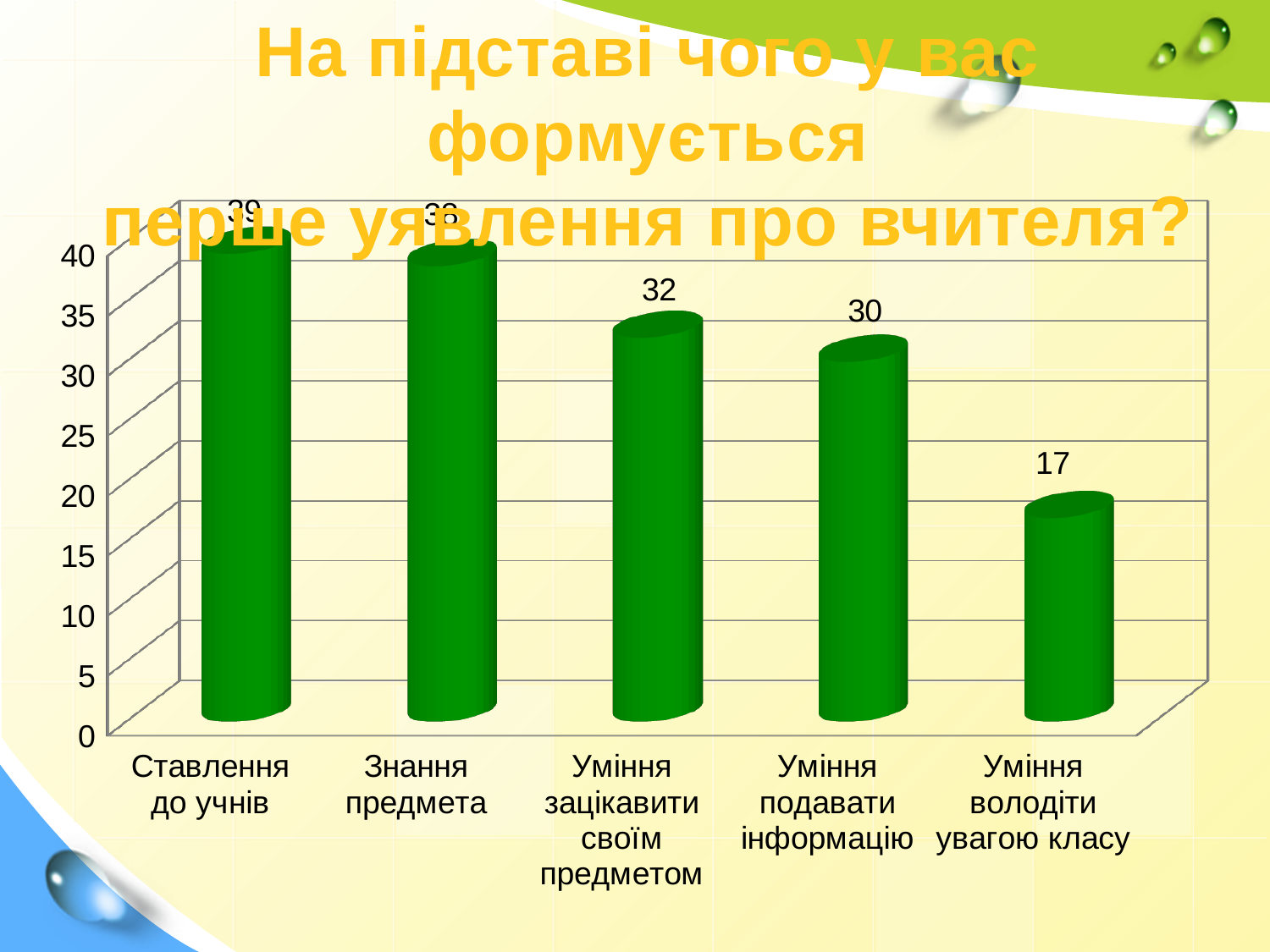
Which category has the lowest value? Уміння володіти увагою класу What is the difference between the values for "Уміння зацікавити своїм предметом" and "Уміння володіти увагою класу"? 15 What is the value for "Уміння володіти увагою класу"? 17 How many categories are shown in the chart? 5 Do the values rise or fall from left to right across the categories? Fall What is the value for "Уміння зацікавити своїм предметом"? 32 What kind of chart is shown on the slide? Bar chart What is the difference between the values for "Уміння подавати інформацію" and "Уміння володіти увагою класу"? 13 Which is larger: the value for "Уміння зацікавити своїм предметом" or for "Уміння подавати інформацію"? Уміння зацікавити своїм предметом Is the value for "Знання предмета" greater or less than 35? greater Is the value for "Ставлення до учнів" greater or less than 35? greater What is the value for "Уміння подавати інформацію"? 30